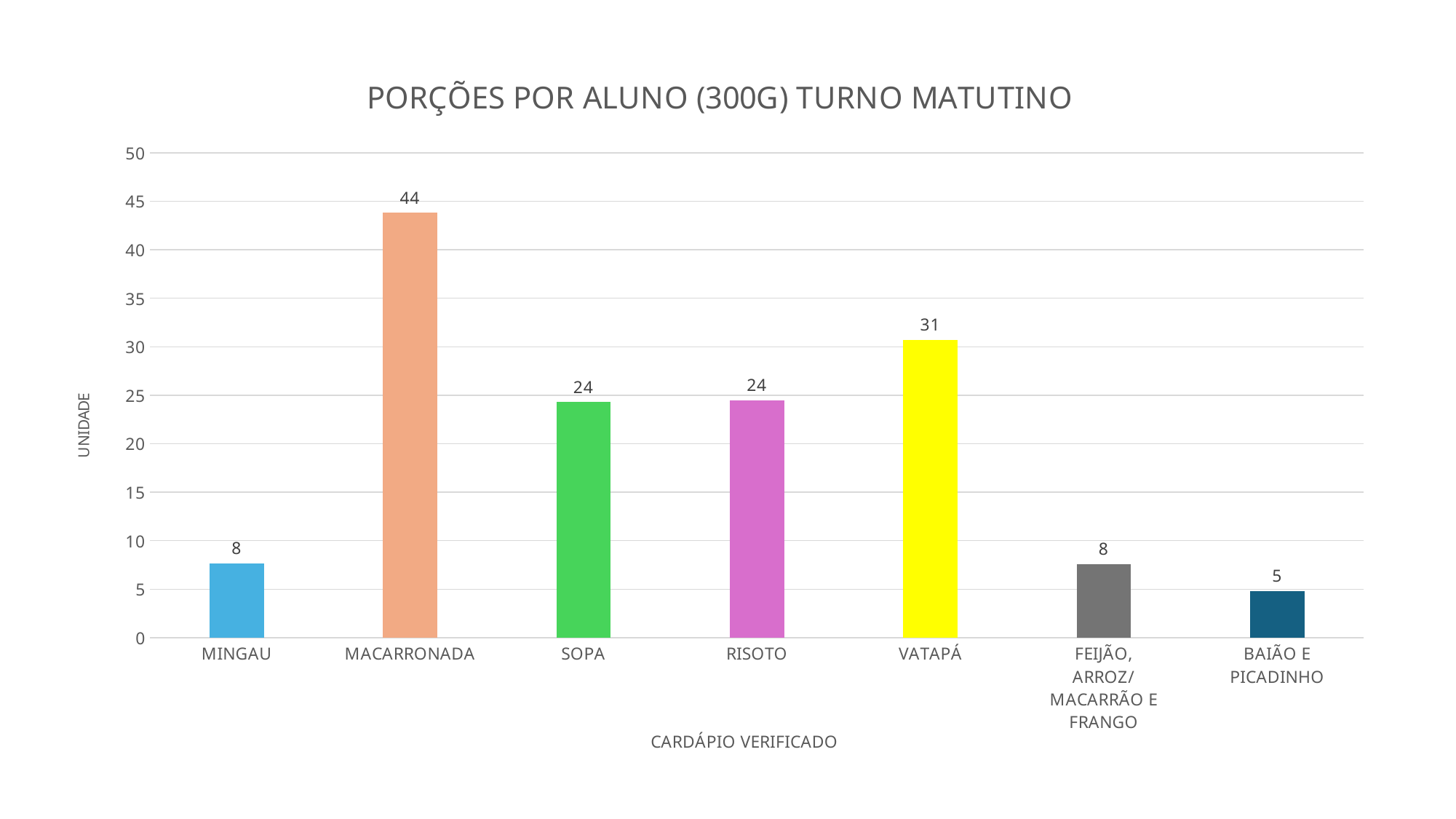
What is the value for MACARRONADA? 44 What is the label of the y axis? UNIDADE What is the value for BAIÃO E PICADINHO? 5 Which category has the highest value? MACARRONADA What kind of chart is shown on the slide? bar chart Which is larger, the value for SOPA or the value for MINGAU? SOPA Which category has the lowest value? BAIÃO E PICADINHO What is the difference between the values for MACARRONADA and VATAPÁ? 13 What is the title of the chart? PORÇÕES POR ALUNO (300G) TURNO MATUTINO What is the value for VATAPÁ? 31 Is the value for VATAPÁ greater or less than 30? greater How many categories are shown on the x axis? 7